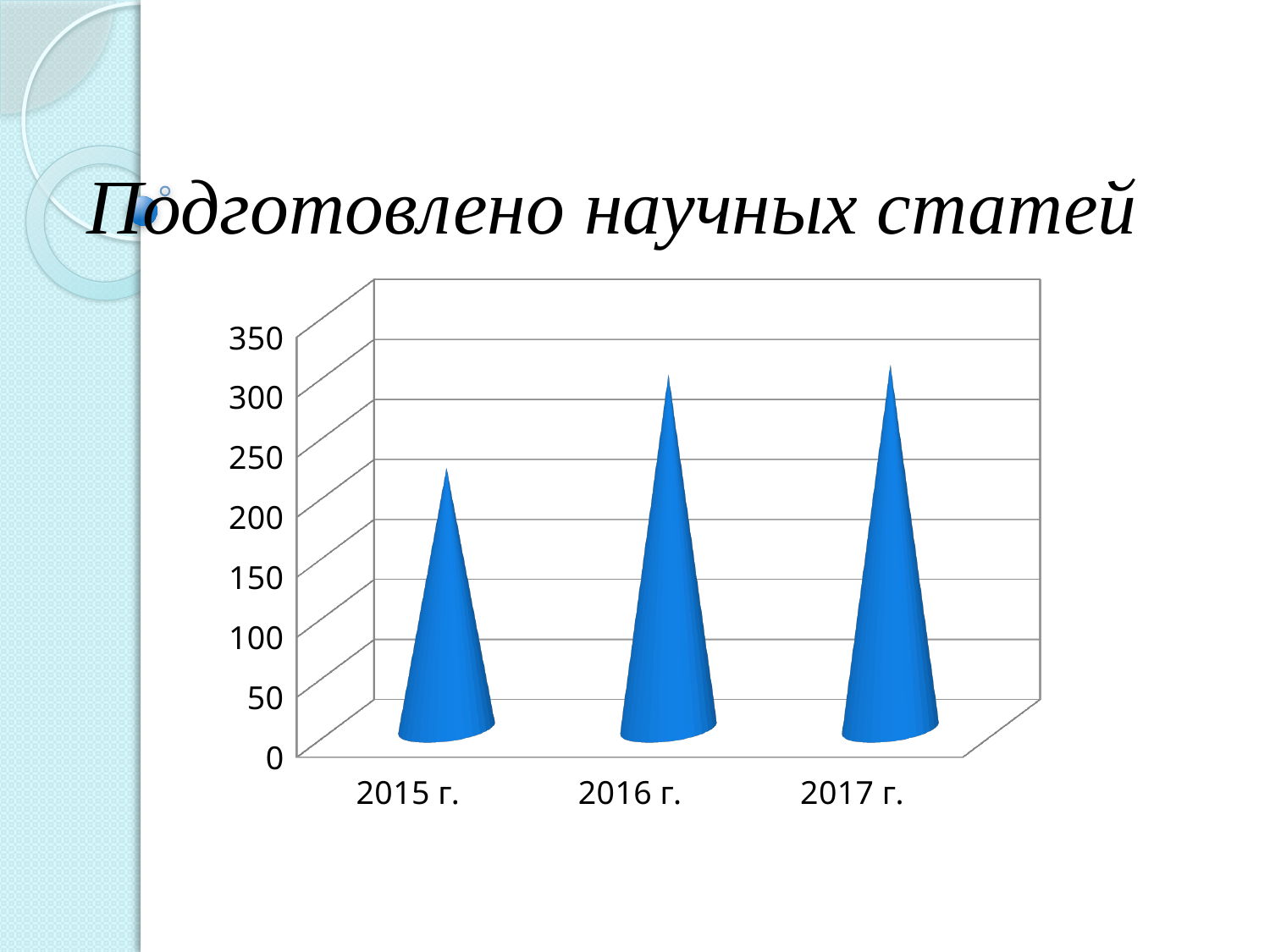
Is the value for 2016 г. greater or less than 250? greater What kind of chart is shown on the slide? bar chart Is the value for 2015 г. greater or less than 300? less What is the title of the slide above the chart? Подготовлено научных статей Which year has the lowest value in the chart? 2015 г. Which is larger, the value for 2015 г. or the value for 2016 г.? 2016 г. Do the values rise or fall from 2015 г. to 2017 г.? rise How many categories (years) are shown on the x axis of the chart? 3 Which is larger, the value for 2015 г. or the value for 2017 г.? 2017 г. Is the value for 2017 г. greater or less than 350? less What colour are the bars in the chart? blue